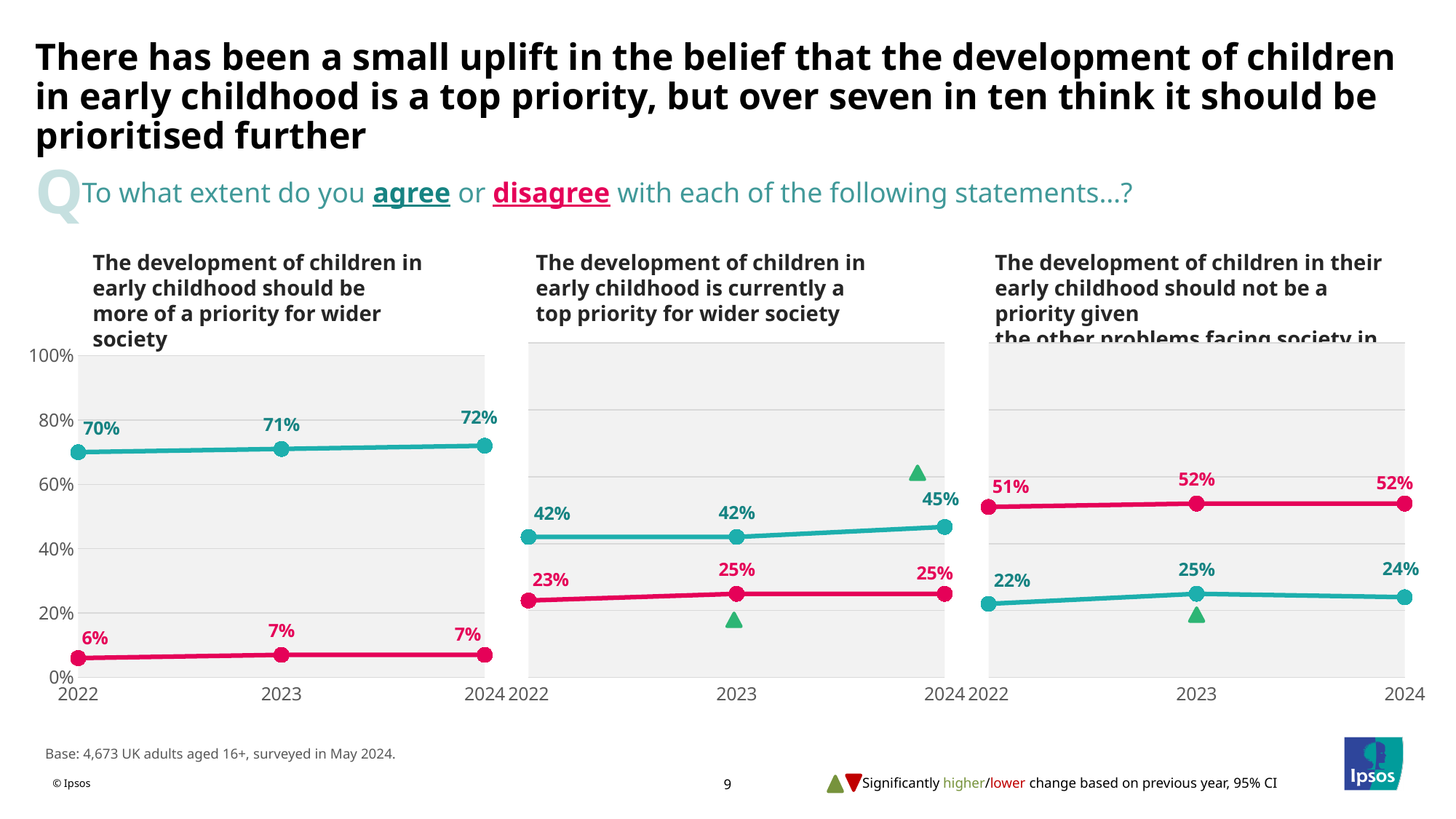
How many years are plotted on the x axis of each chart? 3 In the middle chart ('is currently a top priority for wider society'), what is the agree value for 2024? 45% In the left chart ('should be more of a priority for wider society'), what is the agree value for 2024? 72% In the middle chart, by how many percentage points did the agree value change from 2023 to 2024? 3 percentage points In the right chart, which year has the highest agree value? 2023 In the middle chart ('is currently a top priority for wider society'), what is the disagree value for 2023? 25% In the left chart, what is the difference between the agree and disagree values in 2024? 65 percentage points What type of chart is used on this slide? Line chart In the left chart ('should be more of a priority for wider society'), what is the disagree value for 2022? 6% In the right chart ('should not be a priority given the other problems facing society'), what is the disagree value for 2022? 51% In the right chart ('should not be a priority given the other problems facing society'), what is the agree value for 2023? 25% In the left chart, does the agree line rise or fall from 2022 to 2024? Rise